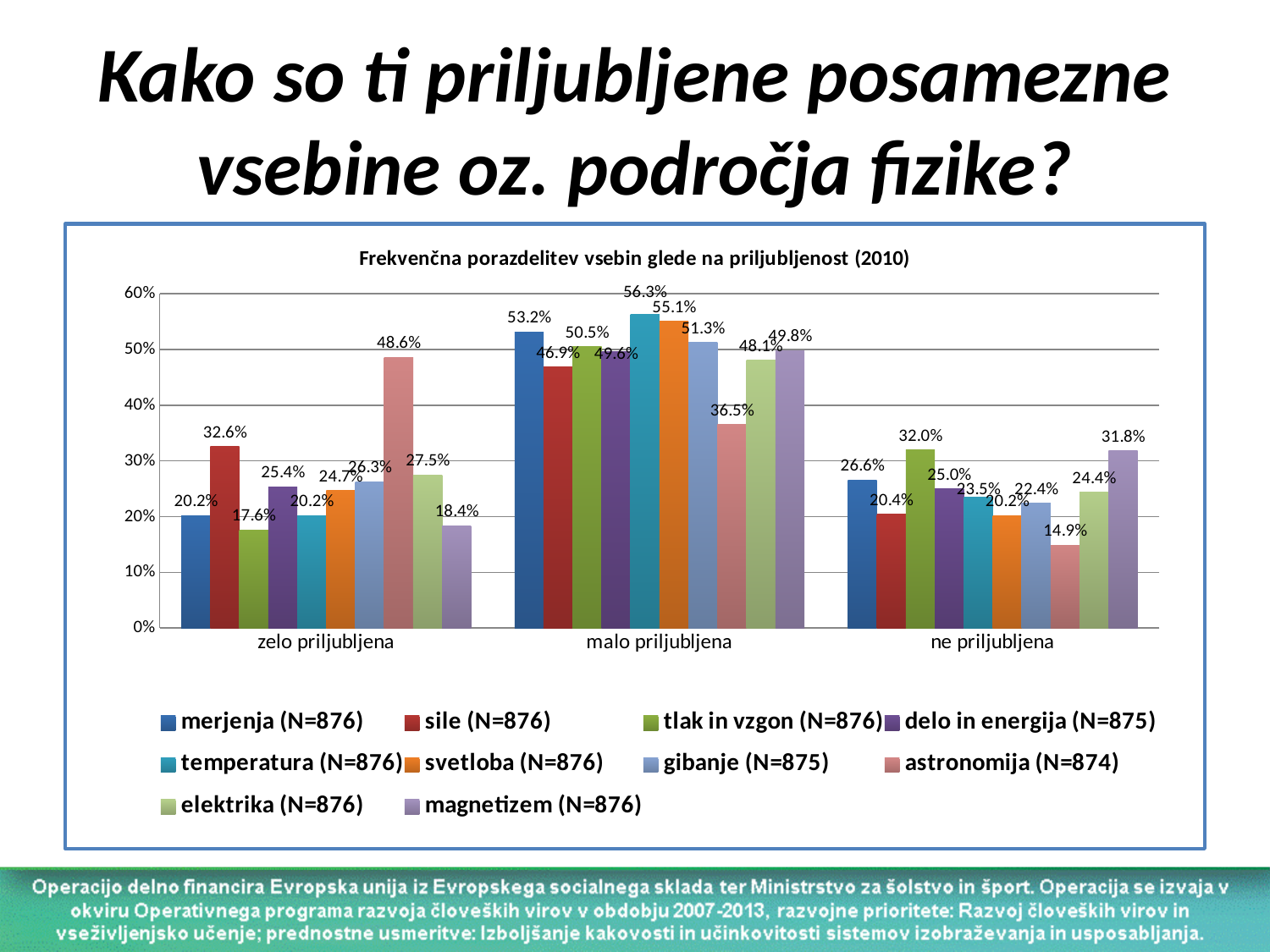
What percentage of respondents rated astronomija as 'zelo priljubljena'? 48.6% Which series has the lowest value in the 'ne priljubljena' category? astronomija (N=874) What is the value for sile in the 'zelo priljubljena' category? 32.6% What is the value for temperatura in the 'malo priljubljena' category? 56.3% Which series has the highest value in the 'zelo priljubljena' category? astronomija (N=874) What is the value for magnetizem in the 'ne priljubljena' category? 31.8% How many categories are shown on the x axis? 3 What is the difference between the 'malo priljubljena' values for temperatura and astronomija? 19.8% What type of chart is shown on the slide? Bar chart Which series has the lowest value in the 'malo priljubljena' category? astronomija (N=874) How many series does the legend list? 10 In the 'ne priljubljena' category, which is larger: tlak in vzgon or sile? tlak in vzgon